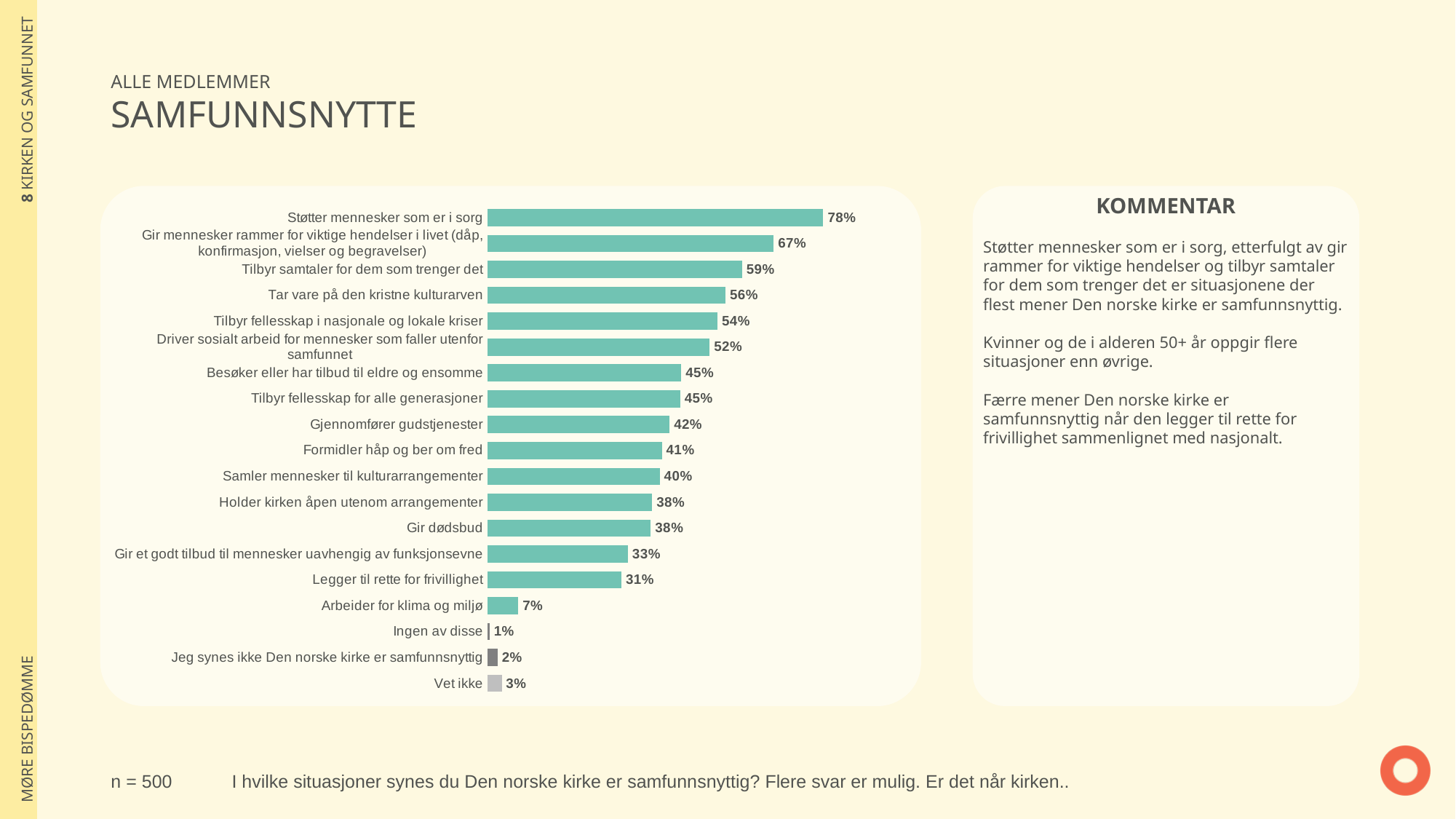
What is the value for "Vet ikke"? 3% What is the difference between "Støtter mennesker som er i sorg" and "Gir mennesker rammer for viktige hendelser i livet (dåp, konfirmasjon, vielser og begravelser)"? 11 percentage points What is the sample size (n) stated on the slide? n = 500 What percentage is shown for "Støtter mennesker som er i sorg"? 78% Which category has the lowest value in the chart? Ingen av disse How many categories are shown in the chart? 19 What is the value for "Tar vare på den kristne kulturarven"? 56% Which is larger: the value for "Gjennomfører gudstjenester" or for "Legger til rette for frivillighet"? Gjennomfører gudstjenester What is the difference between "Tilbyr samtaler for dem som trenger det" and "Gir dødsbud"? 21 percentage points What percentage is shown for "Arbeider for klima og miljø"? 7% What kind of chart is shown on the slide? Bar chart Which category has the highest value in the chart? Støtter mennesker som er i sorg